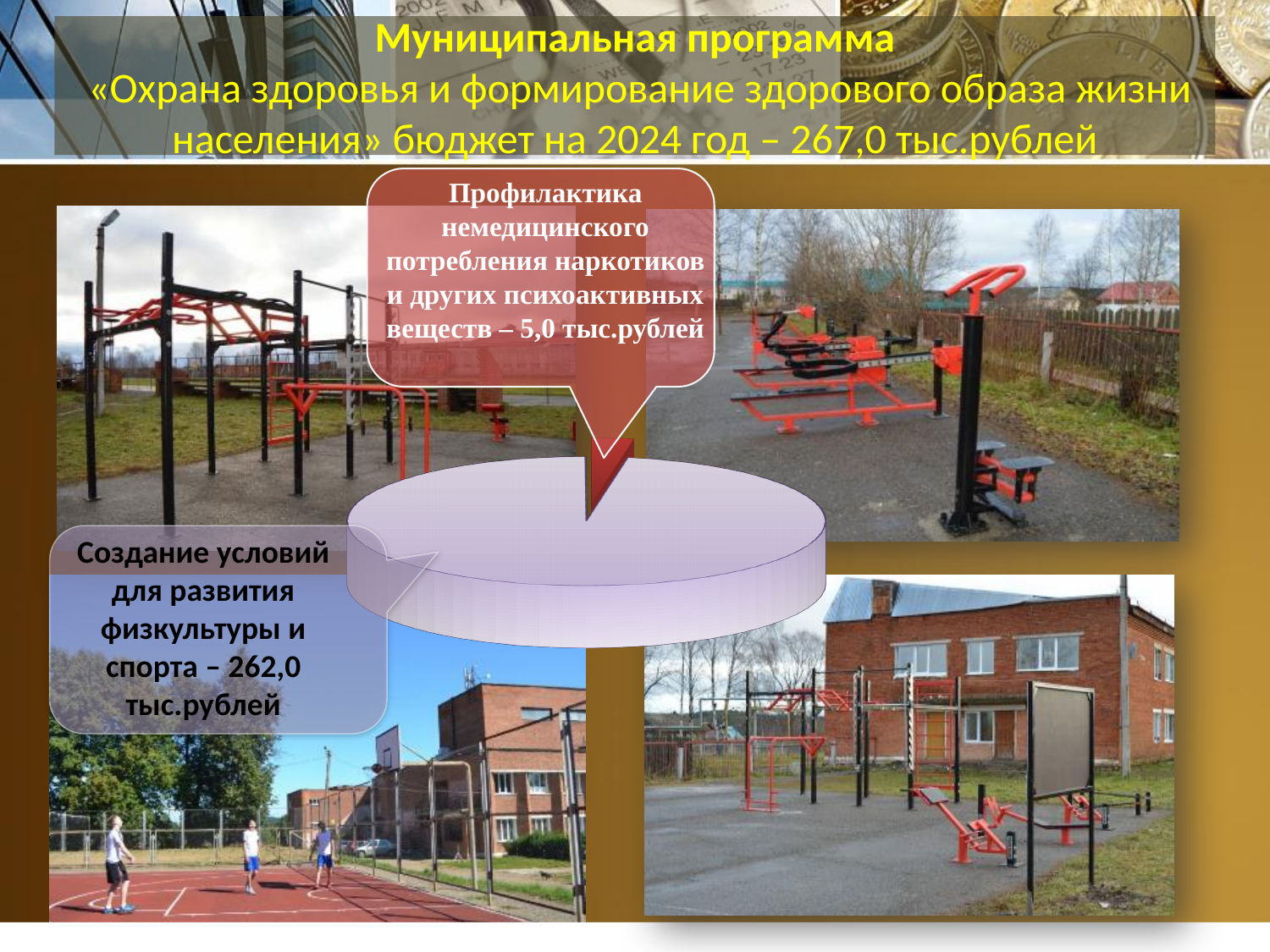
For which year is the budget shown on the slide? 2024 What is the difference between the value for «Создание условий для развития физкультуры и спорта» and the value for «Профилактика немедицинского потребления наркотиков»? 257,0 тыс.рублей What is the name of the municipal programme in the slide title? «Охрана здоровья и формирование здорового образа жизни населения» How many slices does the pie chart have? 2 What is the total budget of the programme for 2024 shown in the slide title? 267,0 тыс.рублей Which is larger: the value for «Создание условий для развития физкультуры и спорта» or for «Профилактика немедицинского потребления наркотиков»? Создание условий для развития физкультуры и спорта Which slice of the pie chart is the smallest? Профилактика немедицинского потребления наркотиков и других психоактивных веществ What is the value for «Создание условий для развития физкультуры и спорта»? 262,0 тыс.рублей What is the value for «Профилактика немедицинского потребления наркотиков и других психоактивных веществ»? 5,0 тыс.рублей Which slice of the pie chart is the largest? Создание условий для развития физкультуры и спорта What type of chart is shown on the slide? Pie chart